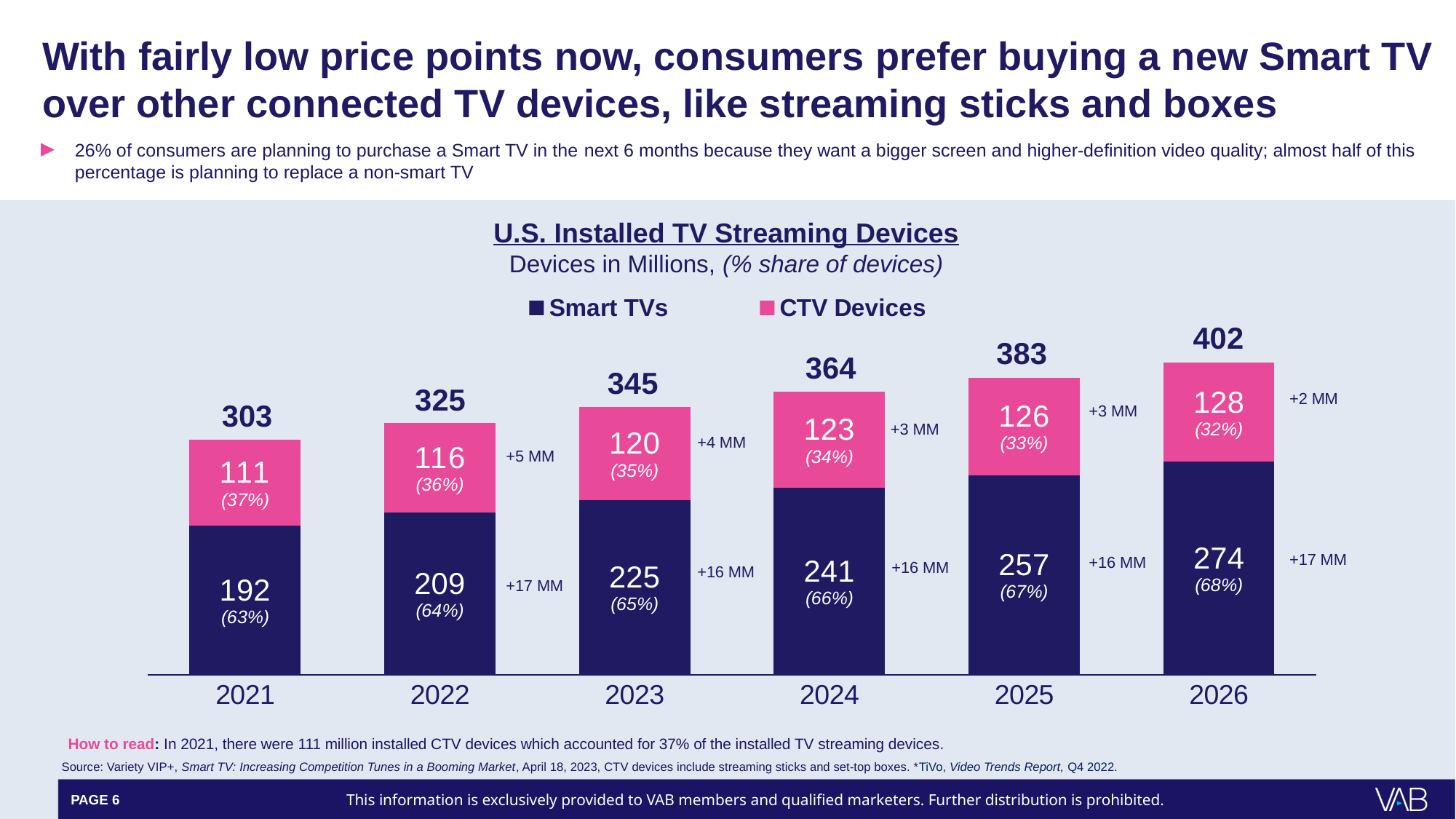
What is the difference between the Smart TVs value in 2026 and in 2021? 82 Which is larger in 2022: the Smart TVs value or the CTV Devices value? Smart TVs What is the total of the stacked bar for 2024? 364 What is the value for Smart TVs in 2023? 225 How many years are shown on the x axis? 6 How many series does the legend list? 2 What is the value for CTV Devices in 2025? 126 Which year has the highest total installed TV streaming devices? 2026 What share of devices do CTV Devices account for in 2021? 37% What kind of chart is shown on the slide? Stacked bar chart Do the total installed devices rise or fall from 2021 to 2026? Rise Which year has the lowest value for Smart TVs? 2021